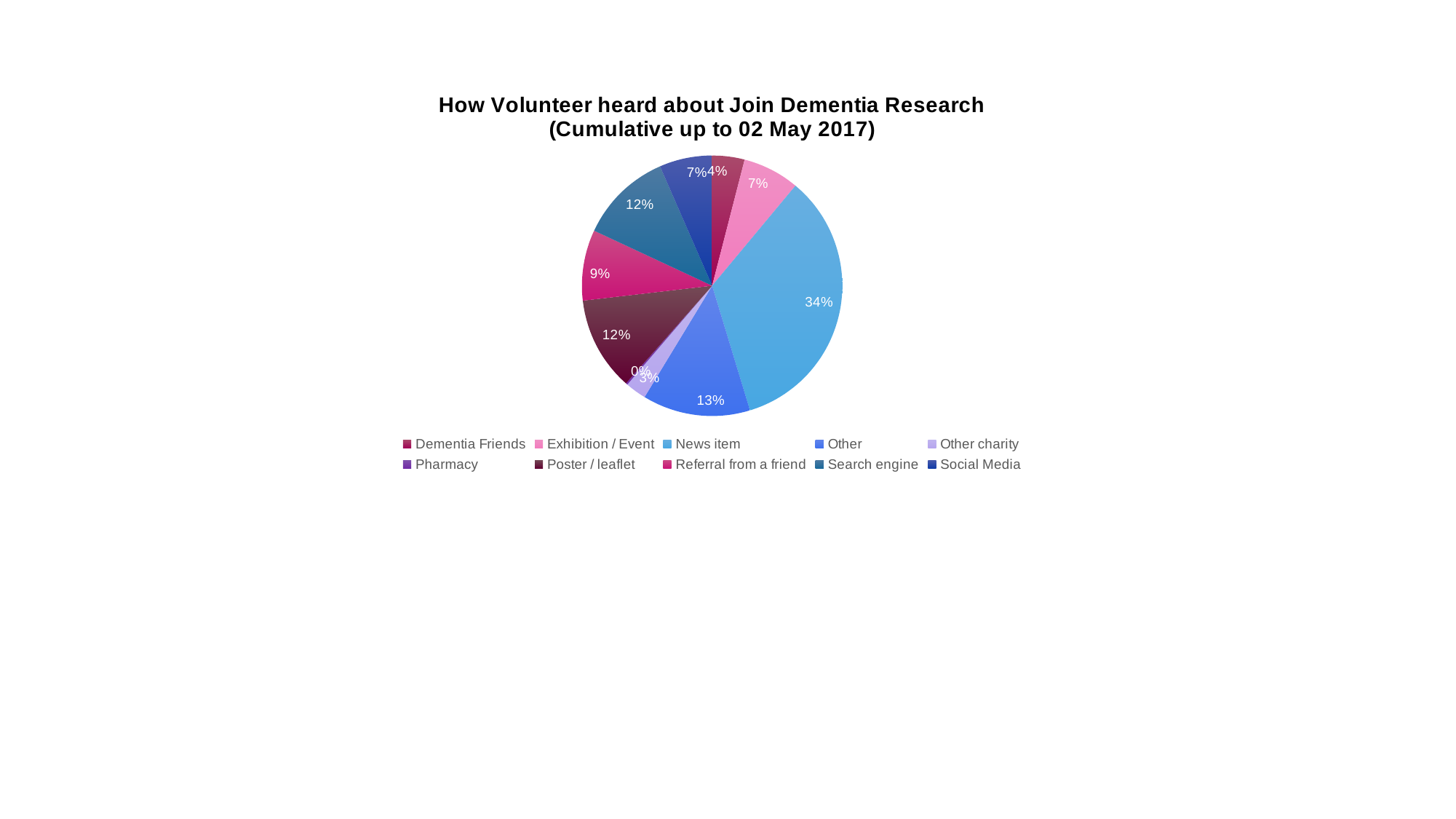
What percentage is shown for Referral from a friend? 9% What percentage is shown for Other charity? 3% What share of the pie does News item account for? 34% Which is larger, the slice for Other or the slice for Referral from a friend? Other Which category has the smallest slice of the pie? Pharmacy How many categories does the legend list? 10 Which category has the largest slice of the pie? News item What kind of chart is shown on the slide? pie chart How many percentage points larger is News item than Other? 21 What percentage is shown for Pharmacy? 0% What percentage is shown for Other? 13% What percentage is shown for Dementia Friends? 4%